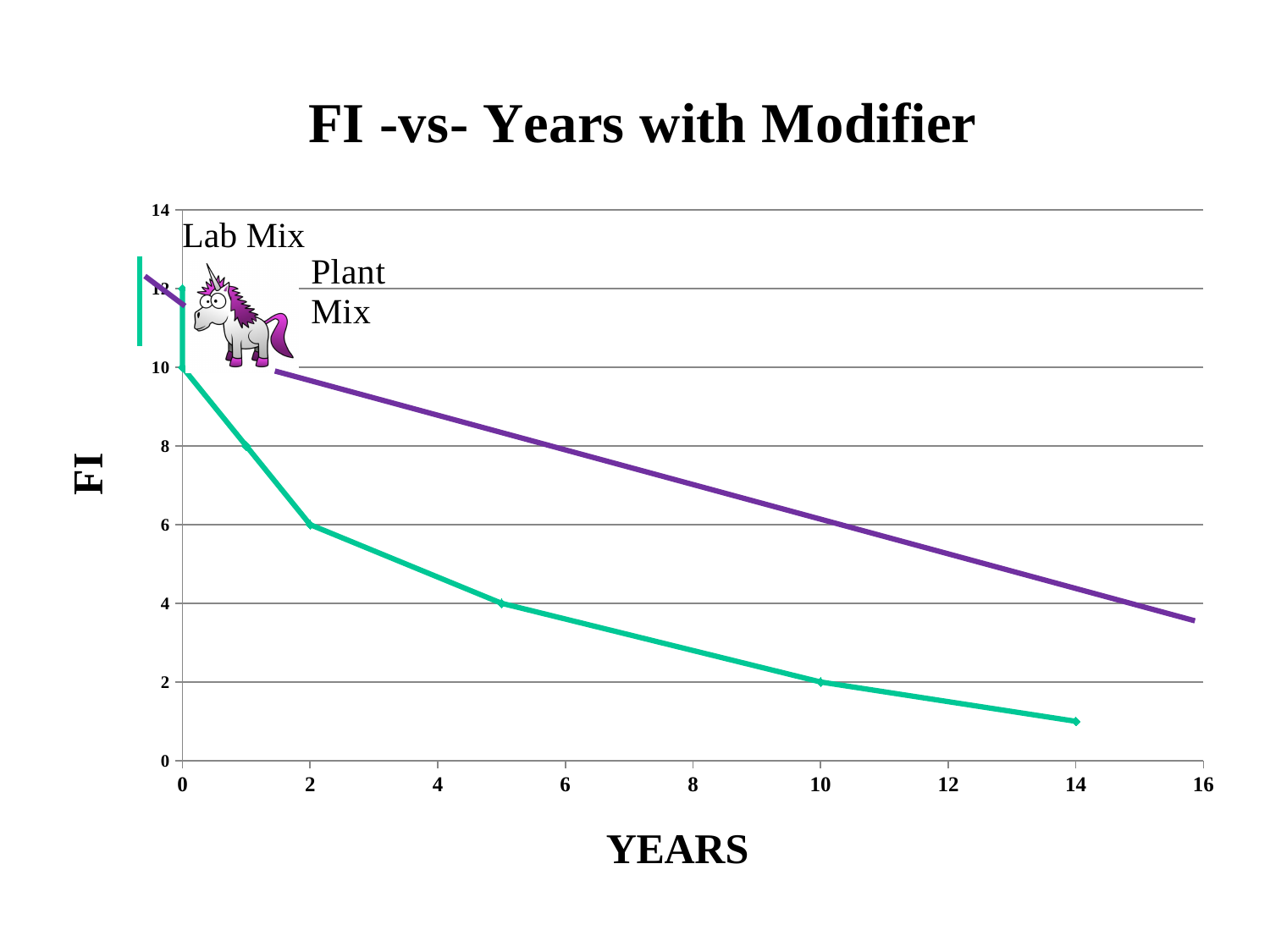
By how much does the Lab Mix FI value drop between year 2 and year 10? 4 At year 10, which line has the higher FI value, Lab Mix or Plant Mix? Plant Mix Is the FI value of the Plant Mix line at year 4 greater or less than 10? less Do the FI values rise or fall as the years increase? fall What is the label of the x axis? YEARS What is the title of the chart? FI -vs- Years with Modifier What is the FI value of the Lab Mix line at year 10? 2 What is the FI value of the Lab Mix line at year 2? 6 Is the FI value of the Plant Mix line at year 8 greater or less than 6? greater What kind of chart is shown on the slide? line chart What is the FI value of the Lab Mix line at year 5? 4